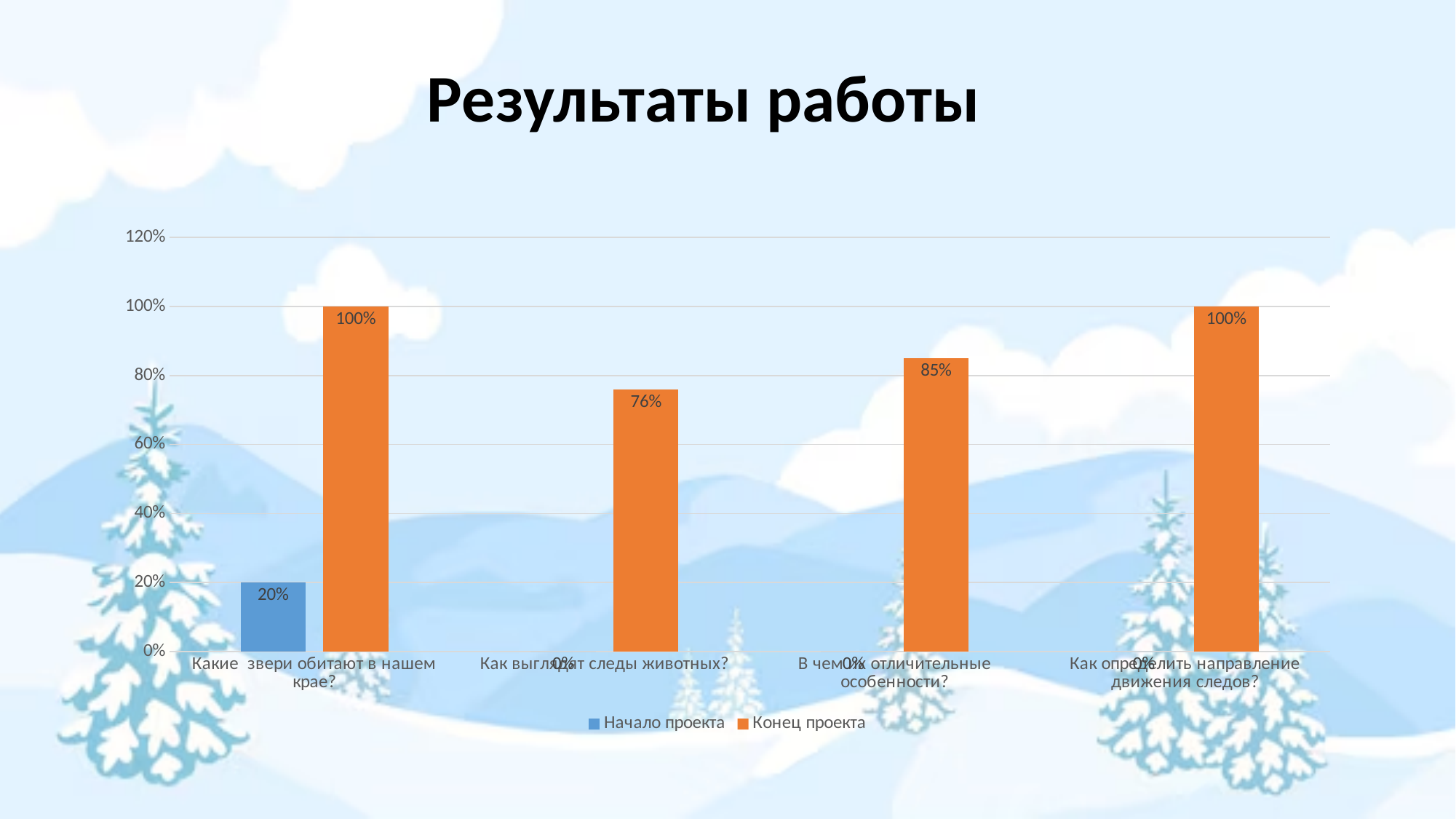
Which category has the lowest "Конец проекта" value? Как выглядят следы животных? What is the value for "Начало проекта" for the category "Какие звери обитают в нашем крае?"? 20% What is the value for "Конец проекта" for the category "Как выглядят следы животных?"? 76% What is the title of the slide? Результаты работы What is the value for "Конец проекта" for the category "В чем их отличительные особенности?"? 85% What is the difference between the "Конец проекта" values for "В чем их отличительные особенности?" and "Как выглядят следы животных?"? 9% Which is larger: the "Конец проекта" value for "Как выглядят следы животных?" or for "В чем их отличительные особенности?"? В чем их отличительные особенности? What is the difference between the "Конец проекта" and "Начало проекта" values for "Какие звери обитают в нашем крае?"? 80% How many series does the legend list? 2 What is the value for "Конец проекта" for the category "Какие звери обитают в нашем крае?"? 100% What kind of chart is shown on the slide? bar chart How many categories are shown on the x axis? 4